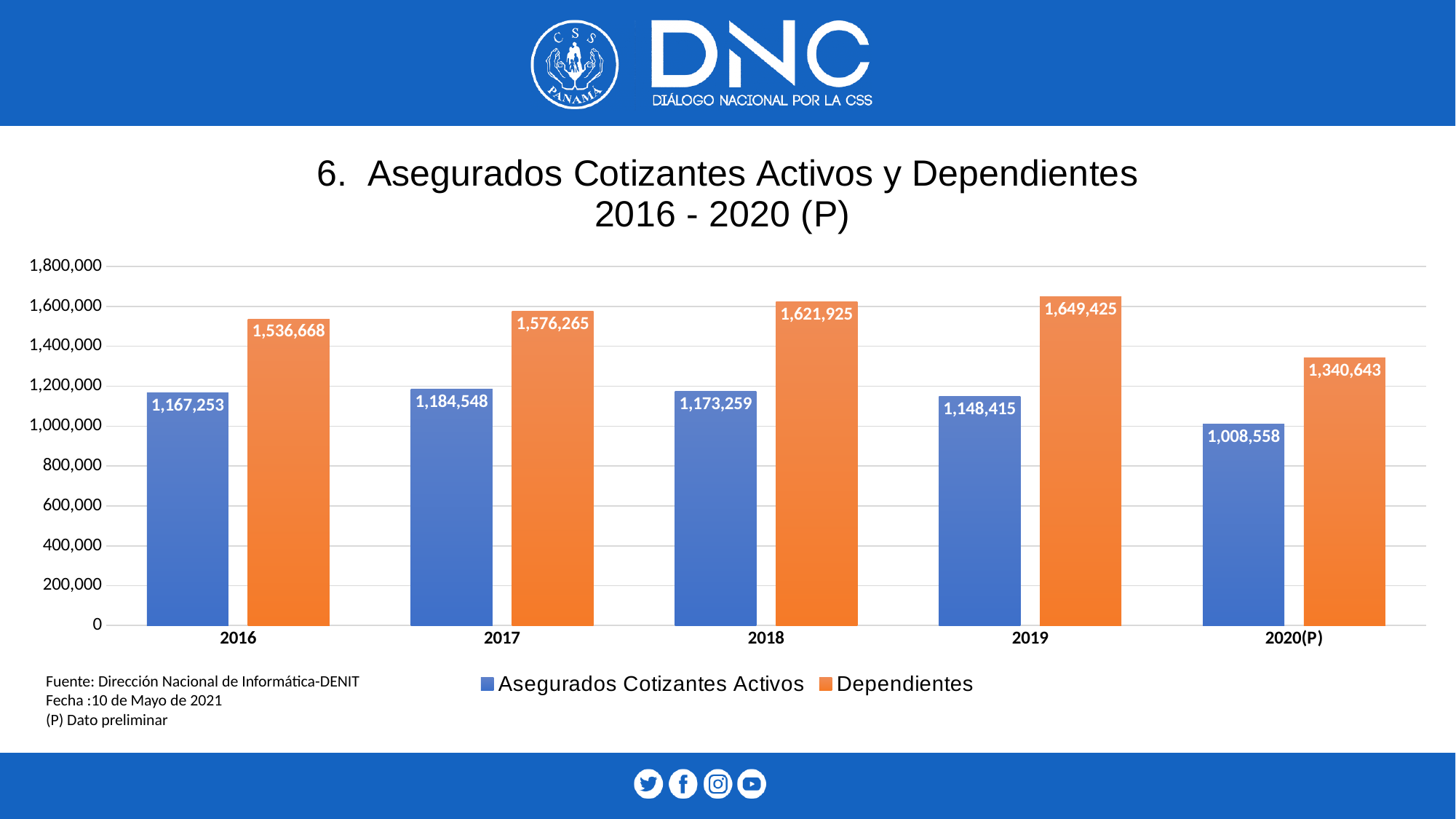
What is the value for Asegurados Cotizantes Activos in 2016? 1,167,253 In which year is the Dependientes value highest? 2019 In which year is the Asegurados Cotizantes Activos value lowest? 2020(P) What is the value for Dependientes in 2018? 1,621,925 What is the value for Asegurados Cotizantes Activos in 2020(P)? 1,008,558 How many series does the legend list? 2 What is the difference between Dependientes and Asegurados Cotizantes Activos in 2019? 501,010 What kind of chart is shown on the slide? bar chart Which is larger in 2017: Asegurados Cotizantes Activos or Dependientes? Dependientes What is the difference between Dependientes and Asegurados Cotizantes Activos in 2020(P)? 332,085 Is the value for Dependientes in 2020(P) greater or less than 1,400,000? less How many years are shown on the x axis? 5